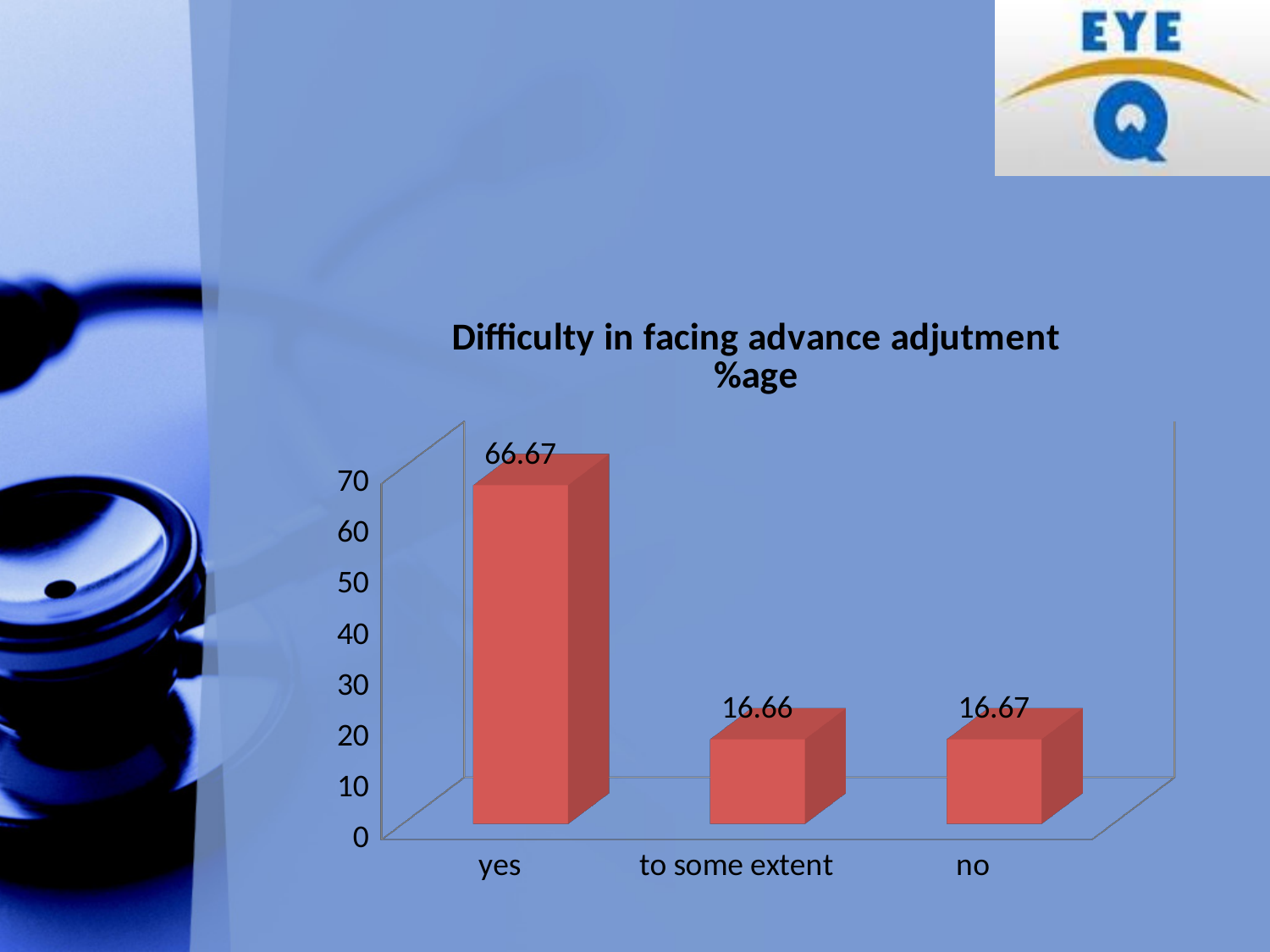
What kind of chart is shown on the slide? bar chart How many categories are shown on the x axis of the chart? 3 What is the value for "yes" in the chart? 66.67 Is the value for "to some extent" greater or less than 20? less What is the difference between the values for "yes" and "no"? 50 What is the title of the chart? Difficulty in facing advance adjutment %age What is the difference between the values for "yes" and "to some extent"? 50.01 Which category has the highest value in the chart? yes Which is larger, the value for "yes" or the value for "no"? yes What is the value for "to some extent" in the chart? 16.66 What is the value for "no" in the chart? 16.67 Is the value for "yes" greater or less than 50? greater